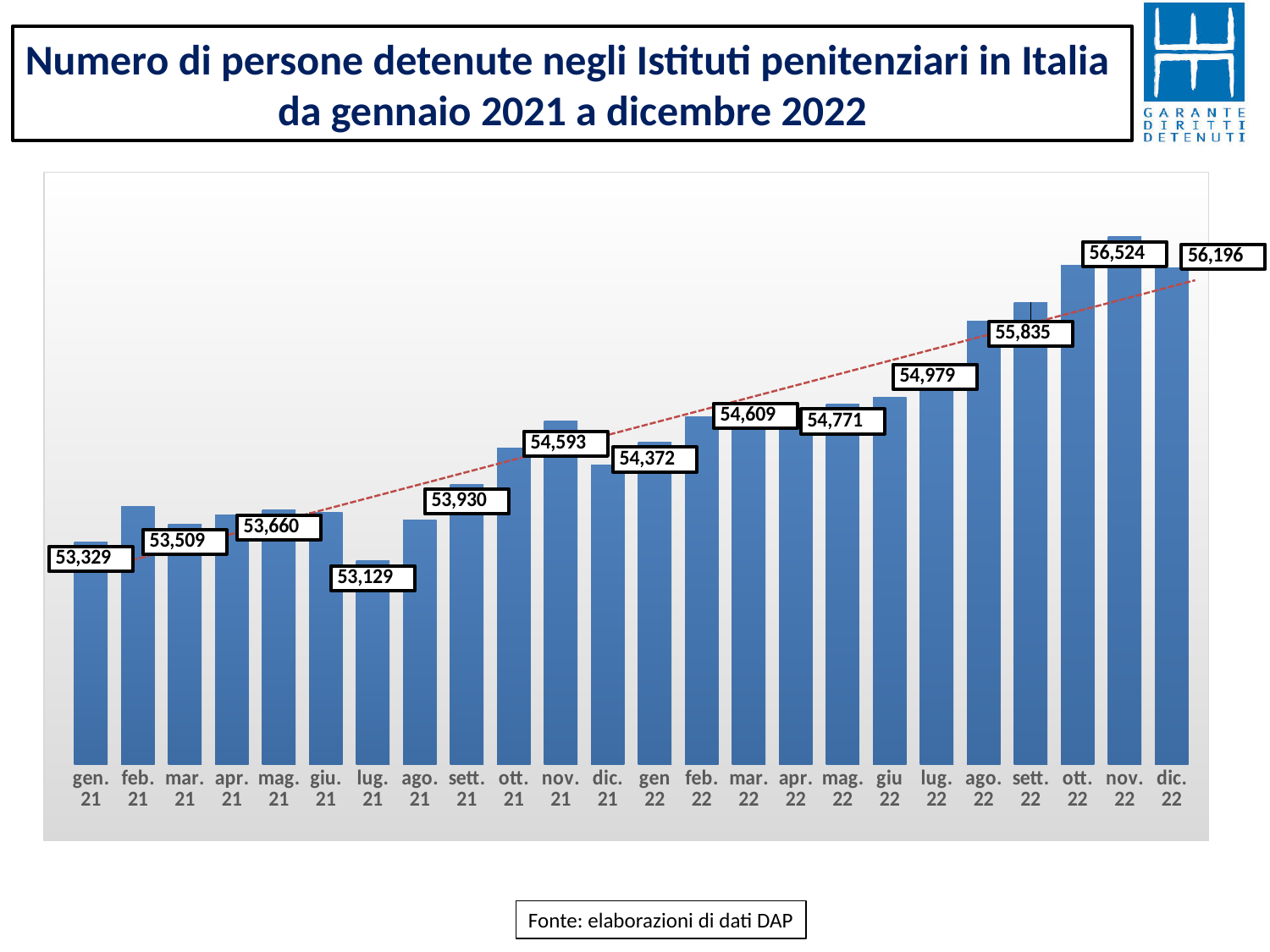
Overall, do the values rise or fall from gen. 21 to dic. 22? rise What is the value shown for nov. 21? 54,593 What is the value shown for nov. 22? 56,524 What is the value shown for lug. 21? 53,129 What kind of chart is shown on the slide? bar chart Which month has the highest number of detained persons? nov. 22 What is the number of detained persons shown for gen. 21? 53,329 How many monthly bars are plotted in the chart? 24 Which is larger, the value for nov. 21 or the value for gen. 22? nov. 21 What is the value shown for dic. 22? 56,196 Which month has the lowest number of detained persons? lug. 21 What is the difference between the values for nov. 22 and dic. 22? 328